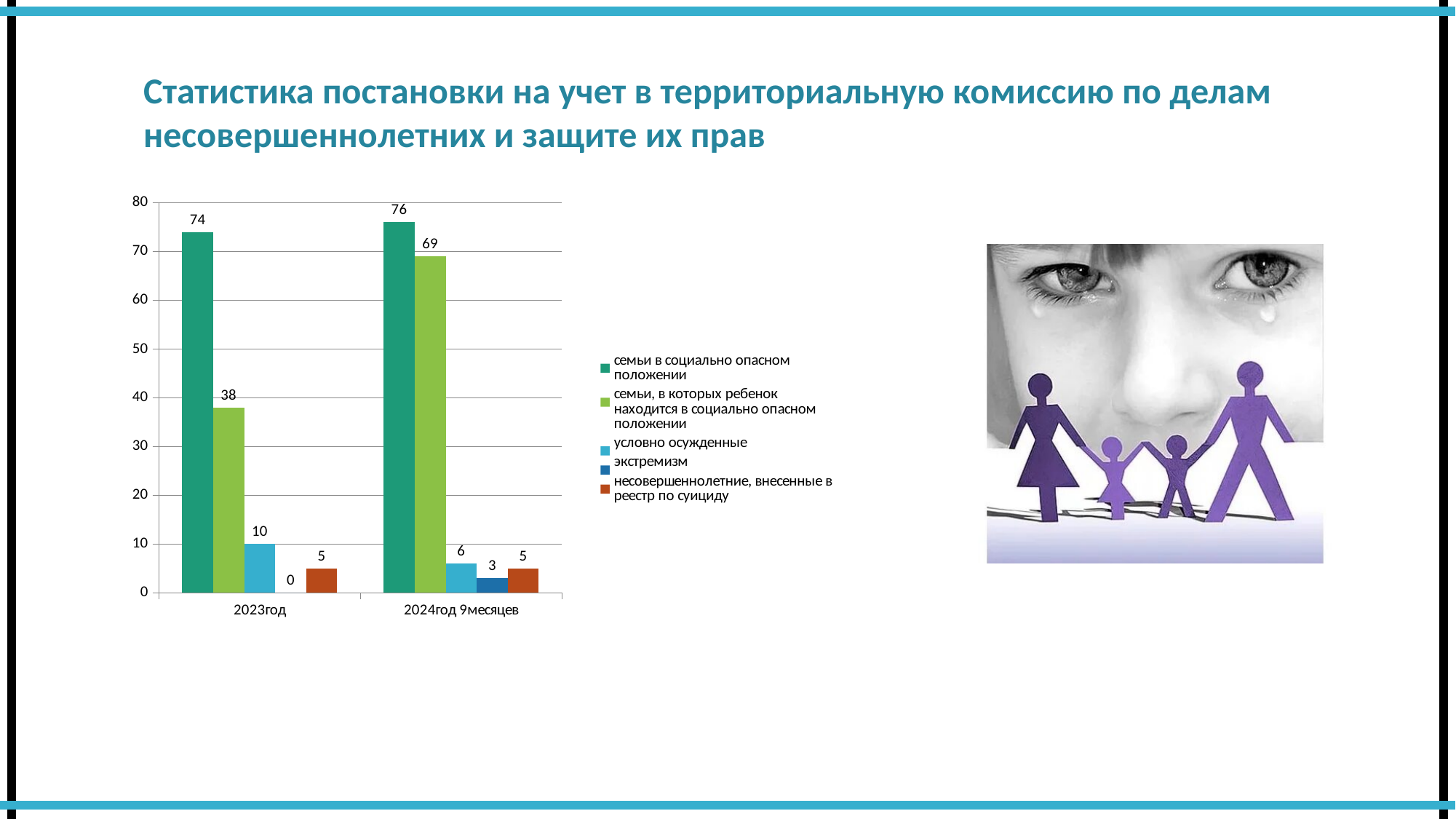
What is the value for "условно осужденные" in 2024год 9месяцев? 6 What is the value for "семьи, в которых ребенок находится в социально опасном положении" in 2024год 9месяцев? 69 How many categories are shown on the x axis? 2 What is the value for "экстремизм" in 2023год? 0 What is the value for "несовершеннолетние, внесенные в реестр по суициду" in 2023год? 5 How many series does the legend list? 5 What kind of chart is shown on the slide? bar chart Which series has the highest value in 2024год 9месяцев? семьи в социально опасном положении What is the value for "семьи в социально опасном положении" in 2023год? 74 Which is larger: the value for "условно осужденные" in 2023год or in 2024год 9месяцев? 2023год Which series has the lowest value in 2023год? экстремизм What is the difference between the values for "семьи, в которых ребенок находится в социально опасном положении" in 2024год 9месяцев and 2023год? 31